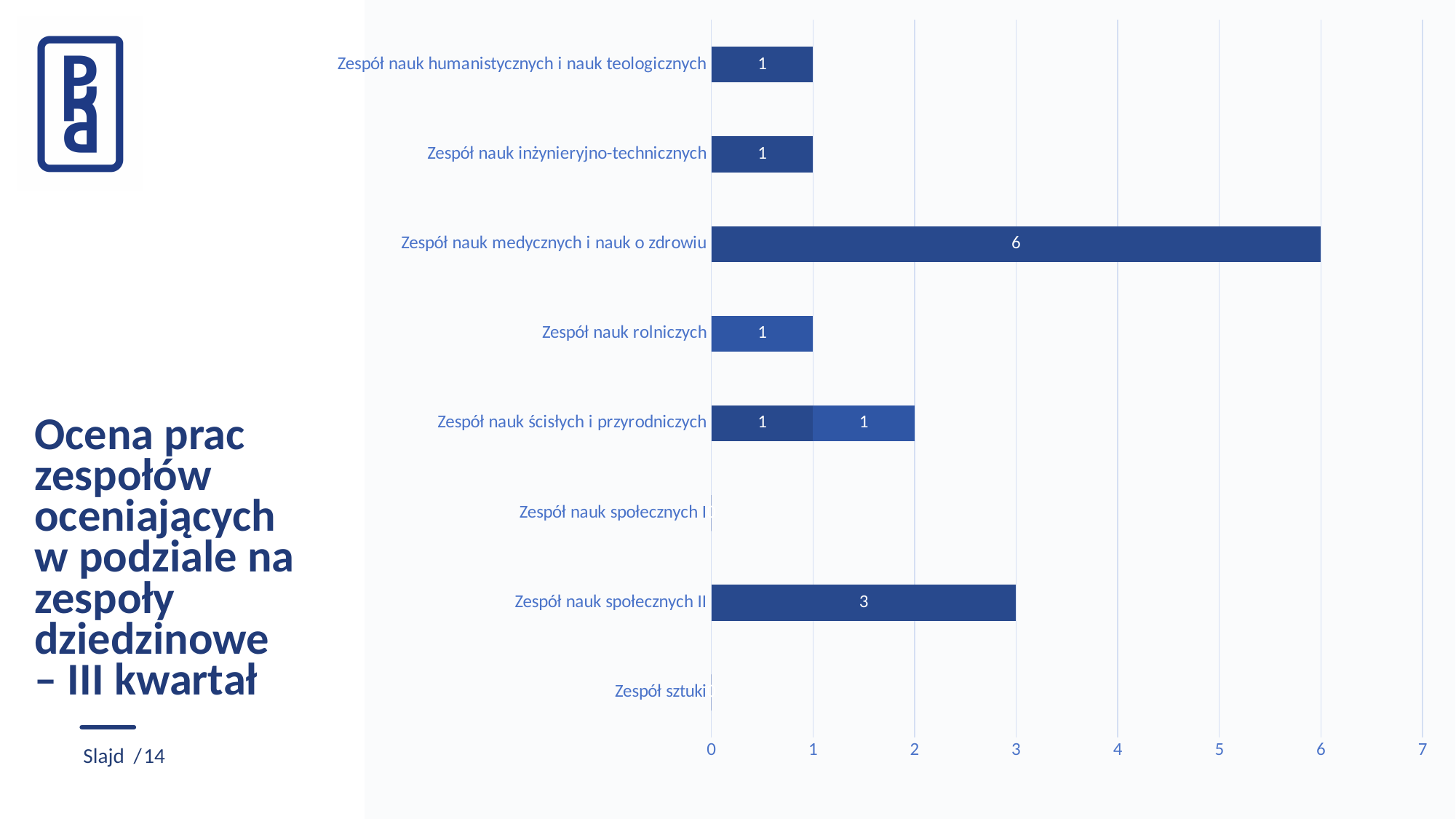
How many categories are listed on the vertical axis of the chart? 8 What kind of chart is shown on the slide? bar chart Which category has the highest value in the chart? Zespół nauk medycznych i nauk o zdrowiu What is the highest value shown on the horizontal axis of the chart? 7 What is the value shown for Zespół nauk inżynieryjno-technicznych? 1 What is the total of the stacked bar for Zespół nauk ścisłych i przyrodniczych? 2 What is the value shown for Zespół nauk medycznych i nauk o zdrowiu? 6 What is the value shown for Zespół nauk społecznych II? 3 Which is larger: the value for Zespół nauk społecznych II or the value for Zespół nauk humanistycznych i nauk teologicznych? Zespół nauk społecznych II What is the value shown for Zespół nauk rolniczych? 1 What is the difference between the values for Zespół nauk medycznych i nauk o zdrowiu and Zespół nauk społecznych II? 3 Is the value for Zespół nauk medycznych i nauk o zdrowiu greater or less than 5? greater